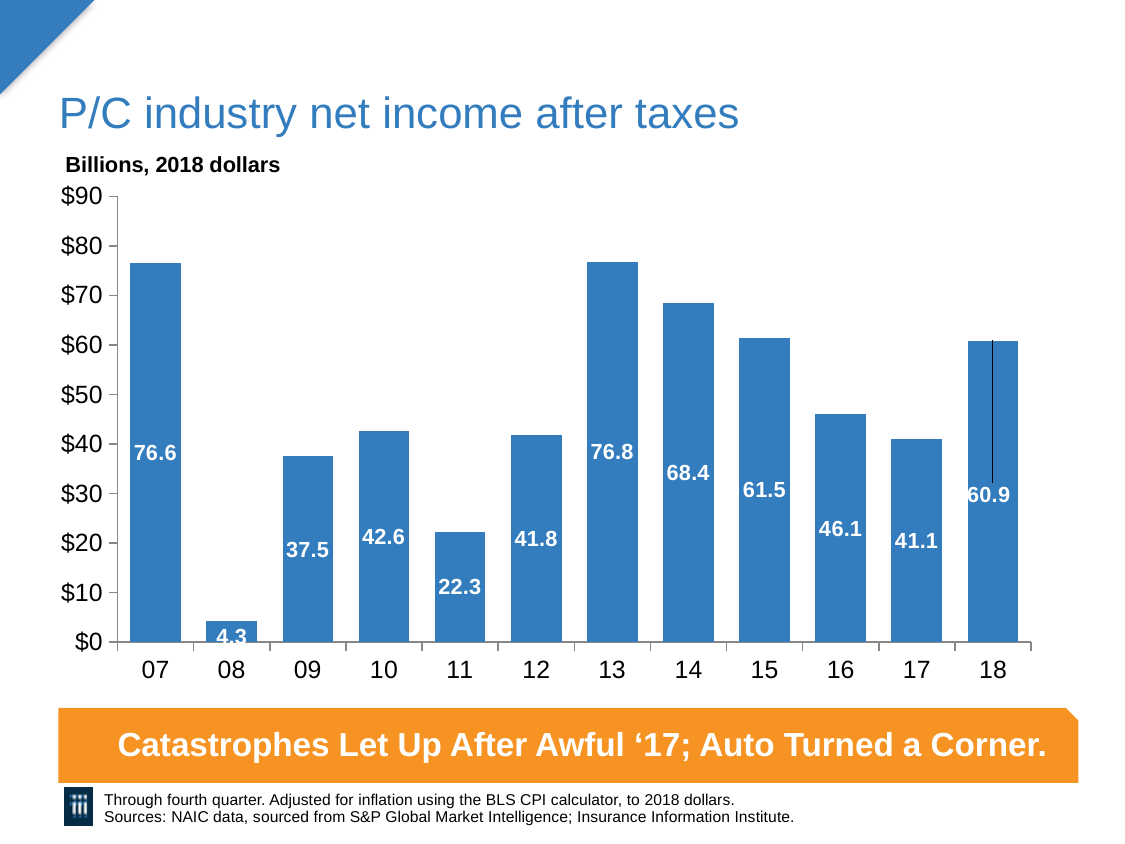
What is the value shown for 2018? 60.9 Is the value for 2011 greater or less than $30? less How many years are shown on the x axis? 12 Which year has the lowest net income after taxes? 08 Which is larger, the value for 2014 or the value for 2015? 2014 Which year has the highest net income after taxes? 13 What unit is stated above the chart? Billions, 2018 dollars What is the P/C industry net income after taxes for 2013? 76.8 What is the value shown for 2008? 4.3 What kind of chart is shown on the slide? bar chart What is the difference between the values for 2018 and 2017? 19.8 Do the values rise or fall from 2015 to 2017? fall